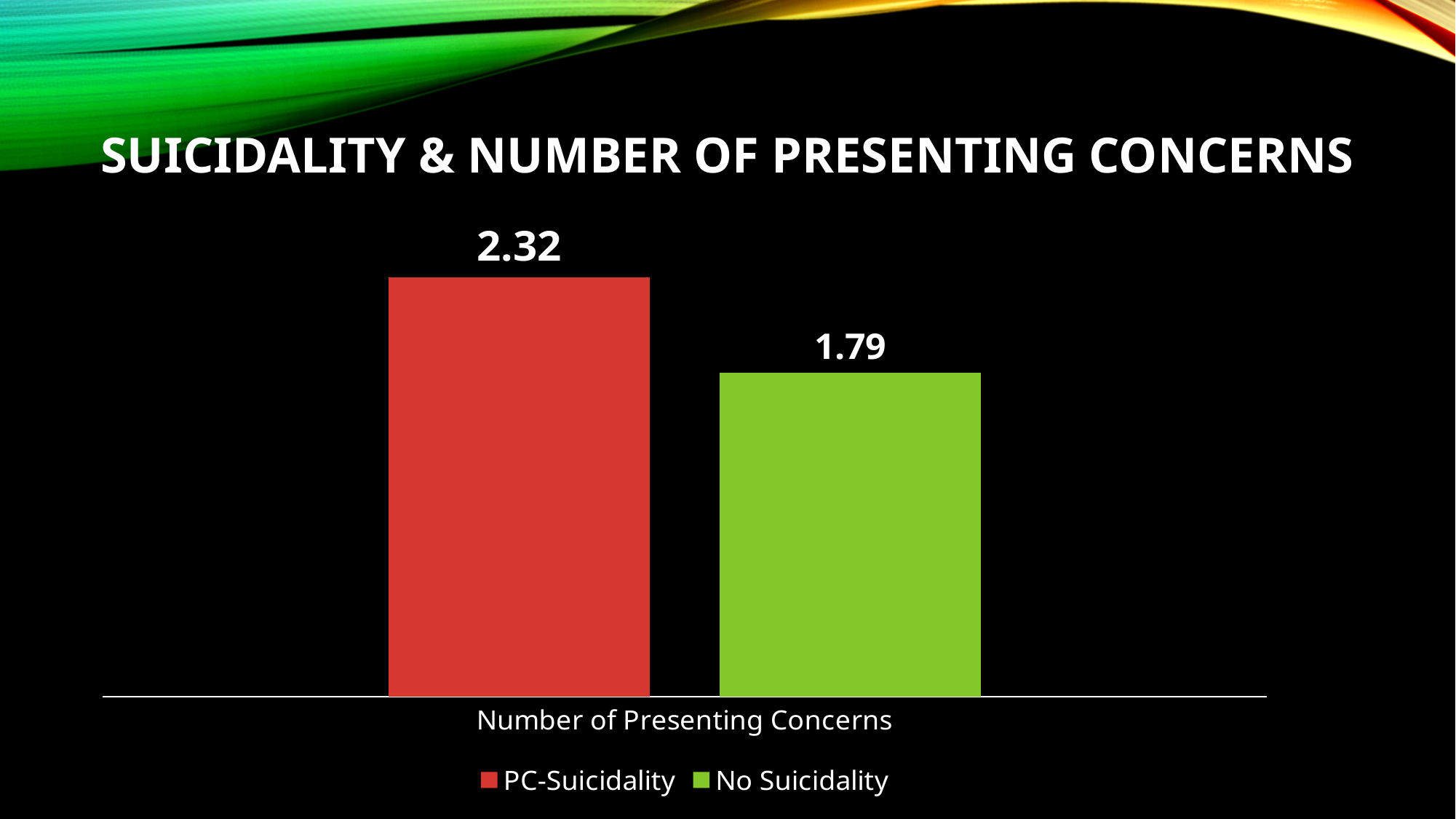
What is the value for PC-Suicidality? 2.32 What is the title of the chart? Suicidality & Number of Presenting Concerns What is the value for No Suicidality? 1.79 Which series has the higher value? PC-Suicidality How many bars are plotted on the chart? 2 What kind of chart is shown on the slide? bar chart What is the difference between the PC-Suicidality and No Suicidality values? 0.53 What is the category label shown on the x axis? Number of Presenting Concerns Is the value for PC-Suicidality larger or smaller than the value for No Suicidality? larger What colour is the bar for No Suicidality? green How many series does the legend list? 2 Which series has the lower value? No Suicidality